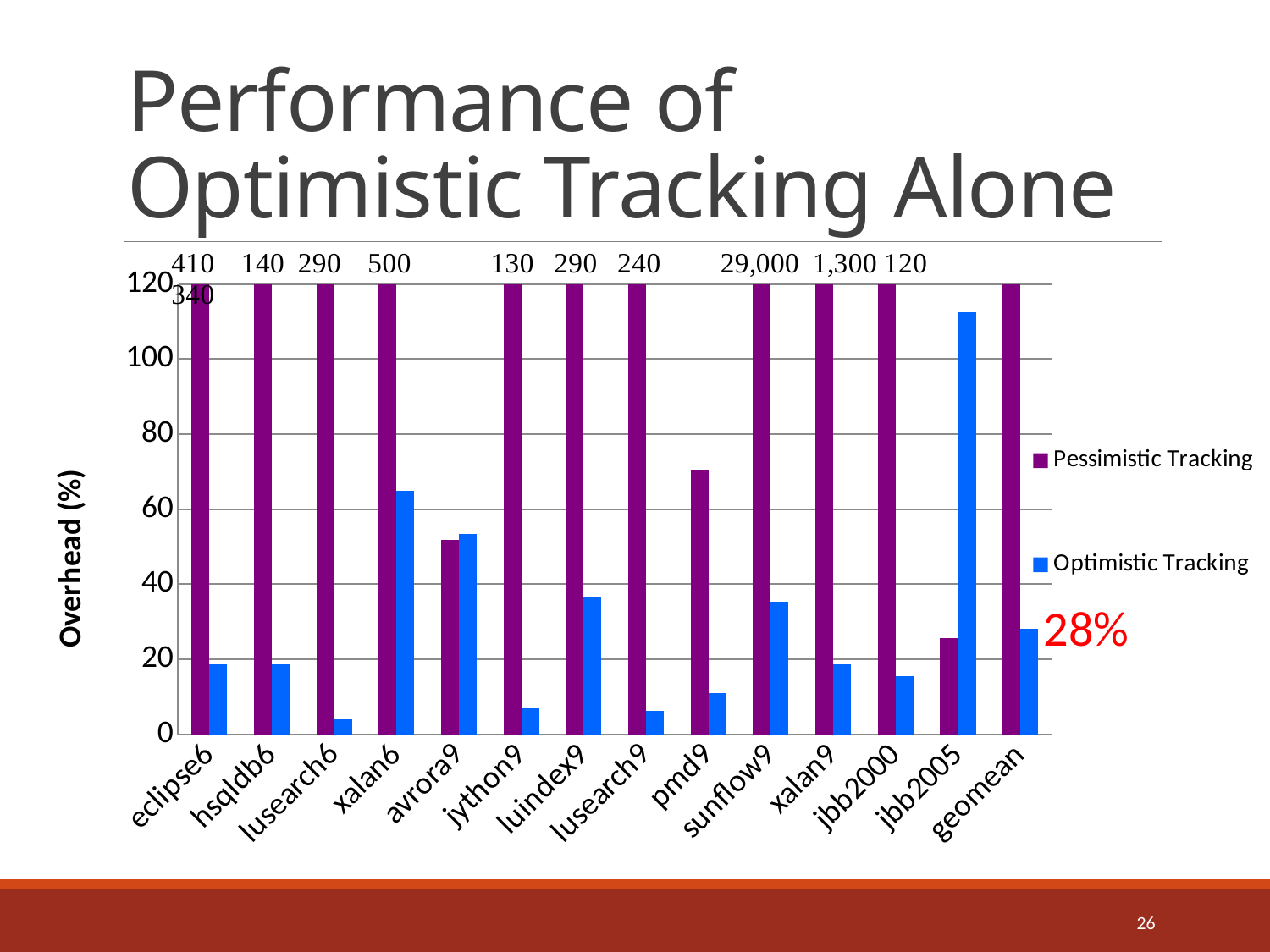
What Pessimistic Tracking overhead value is printed above the sunflow9 bar? 29,000 What Pessimistic Tracking overhead value is printed above the xalan9 bar? 1,300 How many series does the legend list? 2 Is the Optimistic Tracking value for lusearch6 greater or less than 20? less Which category has the highest Optimistic Tracking overhead? jbb2005 For pmd9, which is larger: Pessimistic Tracking or Optimistic Tracking? Pessimistic Tracking What kind of chart is shown on the slide? bar chart How many benchmark categories are shown along the x axis? 14 Is the Optimistic Tracking value for jbb2005 greater or less than 100? greater Is the Optimistic Tracking value for xalan6 greater or less than 60? greater What is the title of the y axis? Overhead (%) What Optimistic Tracking overhead is annotated for geomean? 28%